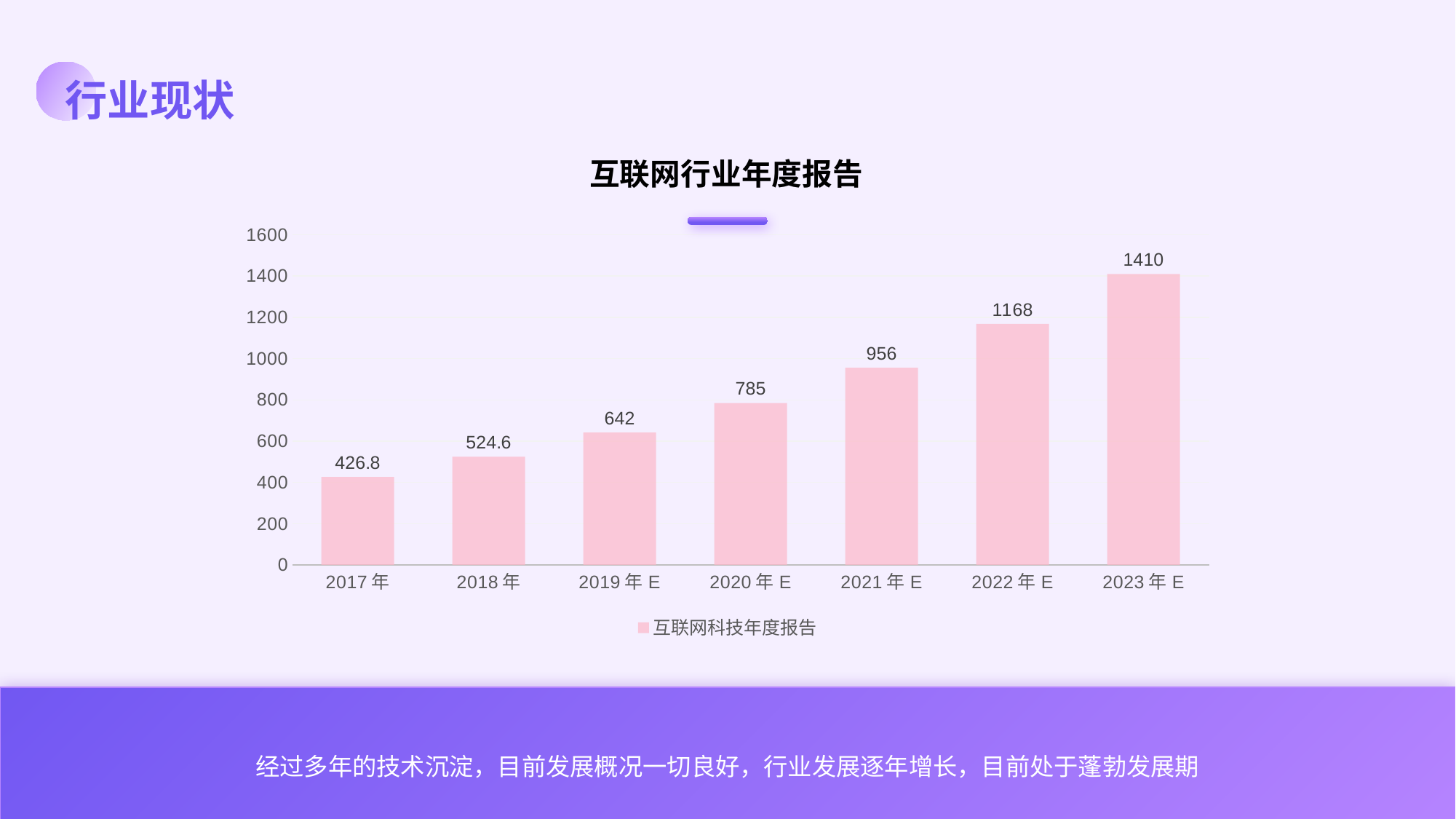
What is the difference between the values for 2022 年 E and 2021 年 E? 212 What is the value for 2017 年? 426.8 What is the difference between the values for 2018 年 and 2017 年? 97.8 What kind of chart is this? Bar chart Which year has the lowest value? 2017 年 Which year has the highest value? 2023 年 E Which is larger, the value for 2019 年 E or the value for 2020 年 E? 2020 年 E What is the value for 2020 年 E? 785 Do the values rise or fall from 2017 年 to 2023 年 E? Rise What is the value for 2023 年 E? 1410 How many years are shown on the x axis? 7 What is the title of the chart? 互联网行业年度报告